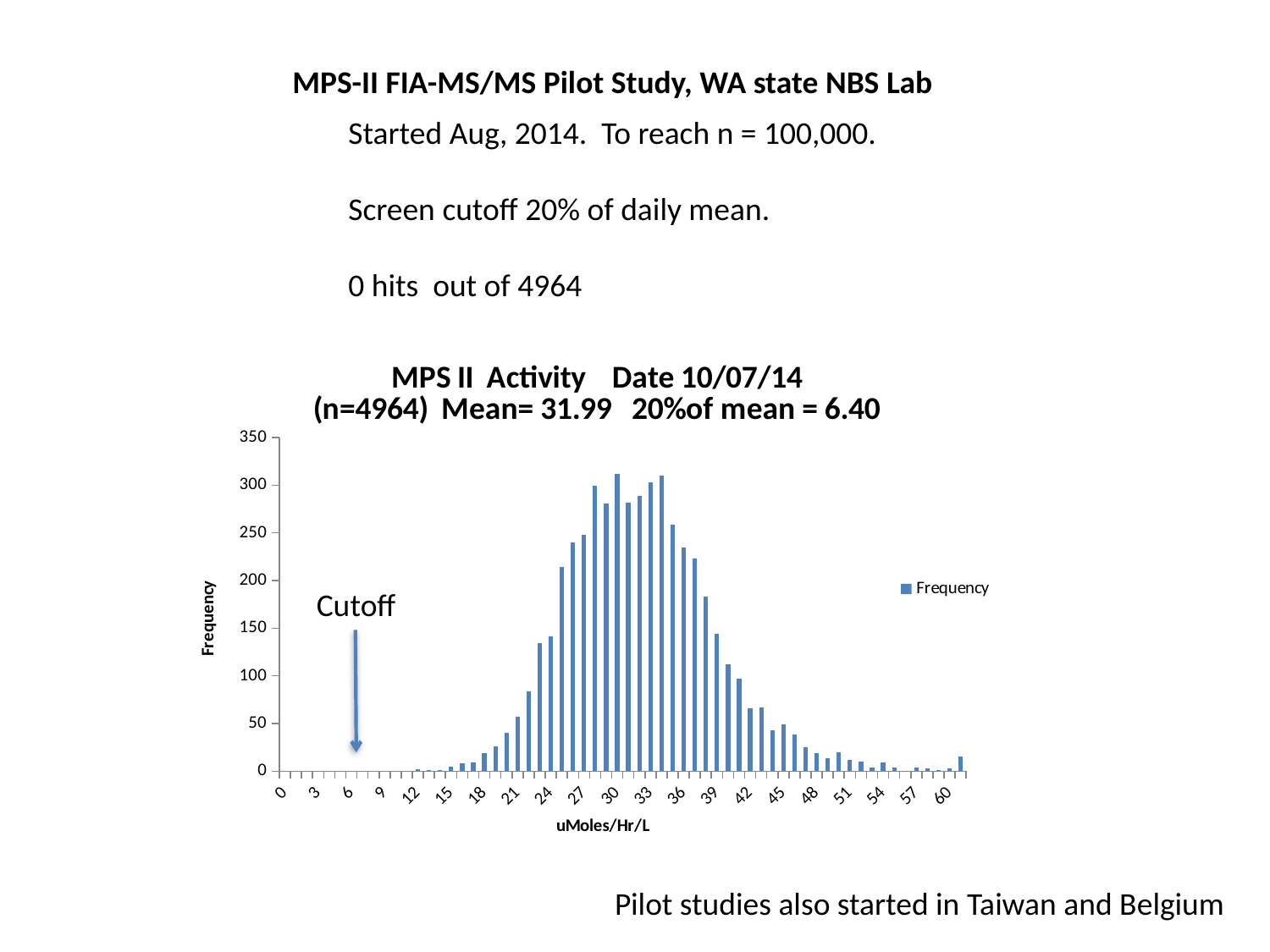
Is the frequency at 36 uMoles/Hr/L greater or less than 200? greater Is the frequency at 39 uMoles/Hr/L greater or less than 200? less Is the frequency at 18 uMoles/Hr/L greater or less than 50? less What kind of chart is shown on the slide? bar chart Between 36 and 48 uMoles/Hr/L, do the frequencies rise or fall along the x axis? fall Between 15 and 27 uMoles/Hr/L, do the frequencies rise or fall along the x axis? rise What is the name of the series shown in the chart legend? Frequency How many series does the chart legend list? 1 What is the label on the x axis of the chart? uMoles/Hr/L